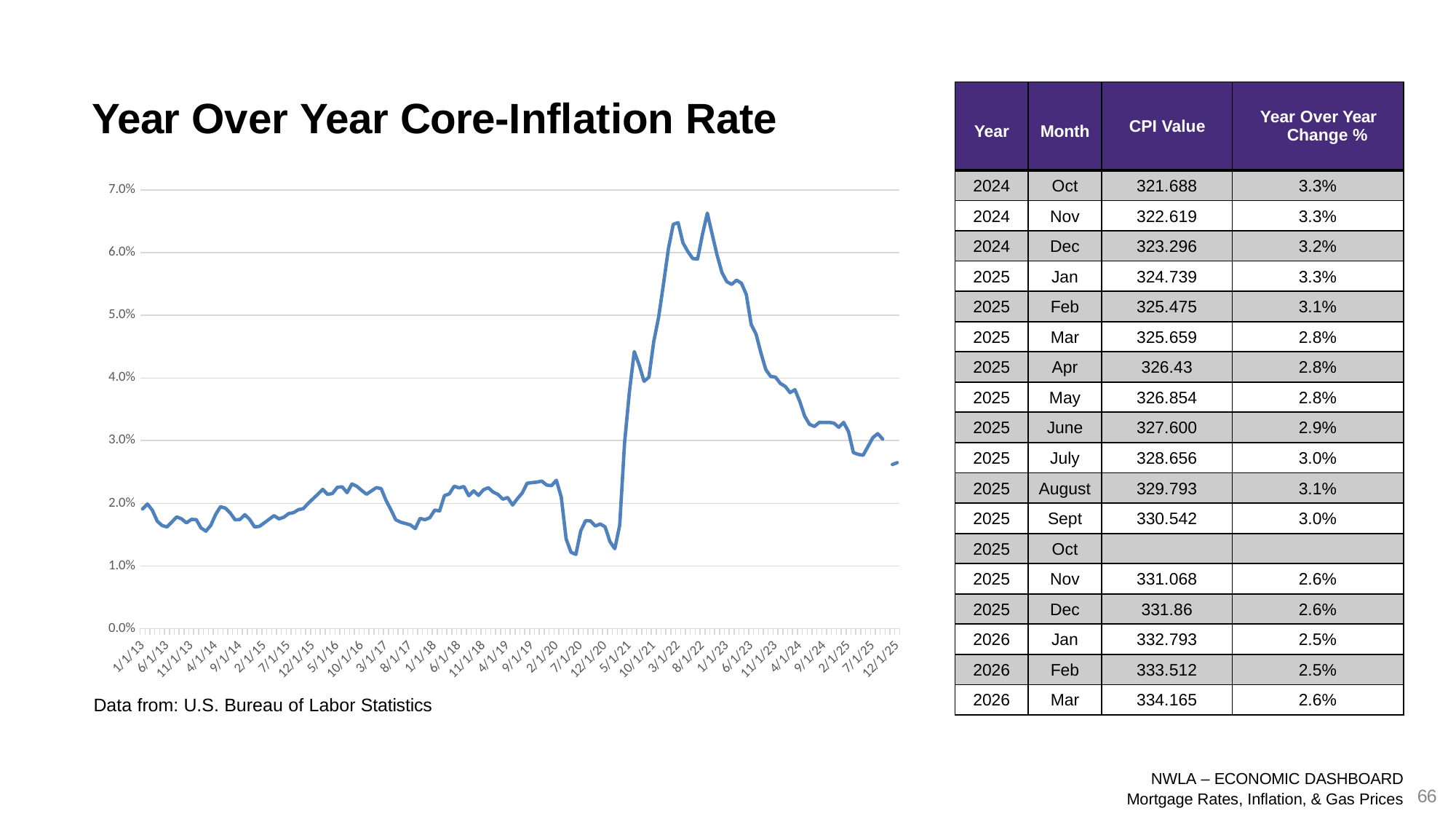
Is the lowest point of the line greater or less than 2.0%? less According to the note under the chart, where is the data from? U.S. Bureau of Labor Statistics Is the value at 12/1/25 greater or less than 3.0%? less In which year does the line reach its highest point? 2022 Between 8/1/22 and 12/1/25, does the line generally rise or fall? fall Is the value at 1/1/13 greater or less than 3.0%? less Between 7/1/20 and 3/1/22, does the line generally rise or fall? rise What kind of chart is shown on the slide? line chart What is the title of the chart? Year Over Year Core-Inflation Rate How many lines (series) are plotted on the chart? 1